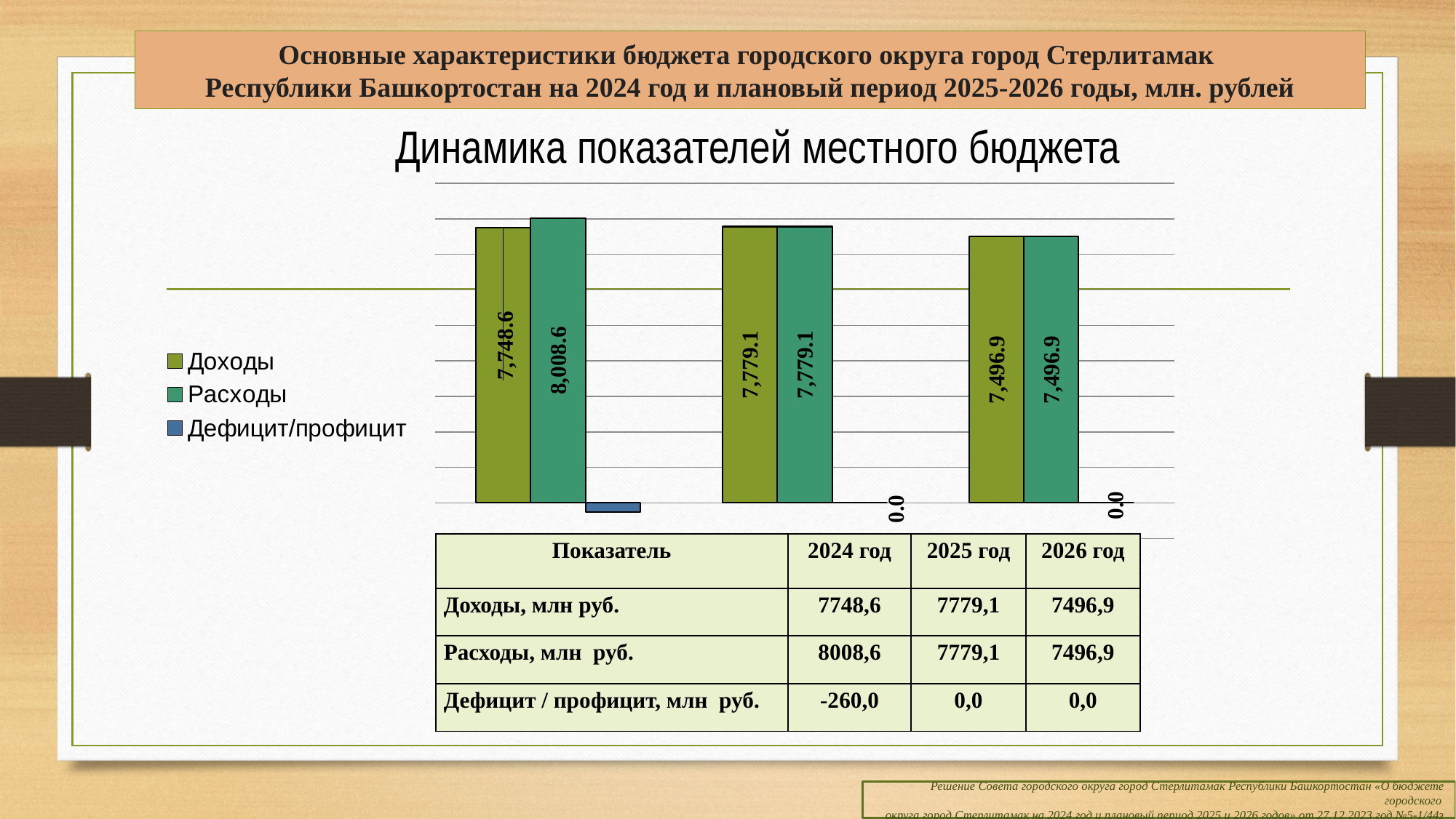
What is the data label on the Расходы bar for 2024 in the chart? 8,008.6 What is the data label on the Доходы bar for 2024 in the chart? 7,748.6 What is the data label on the Расходы bar for 2025 in the chart? 7,779.1 How many groups of bars (years) are plotted in the chart? 3 Which is larger in the chart for 2024: Доходы or Расходы? Расходы Which legend entry is shown in blue in the chart? Дефицит/профицит Which year has the lowest Доходы value in the chart? 2026 How many series does the legend of the chart list? 3 Which year has the highest Расходы value in the chart? 2024 What kind of chart is shown under the title "Динамика показателей местного бюджета"? bar chart What is the data label on the Доходы bar for 2026 in the chart? 7,496.9 What is the difference between the Расходы and Доходы data labels for 2024 in the chart? 260.0